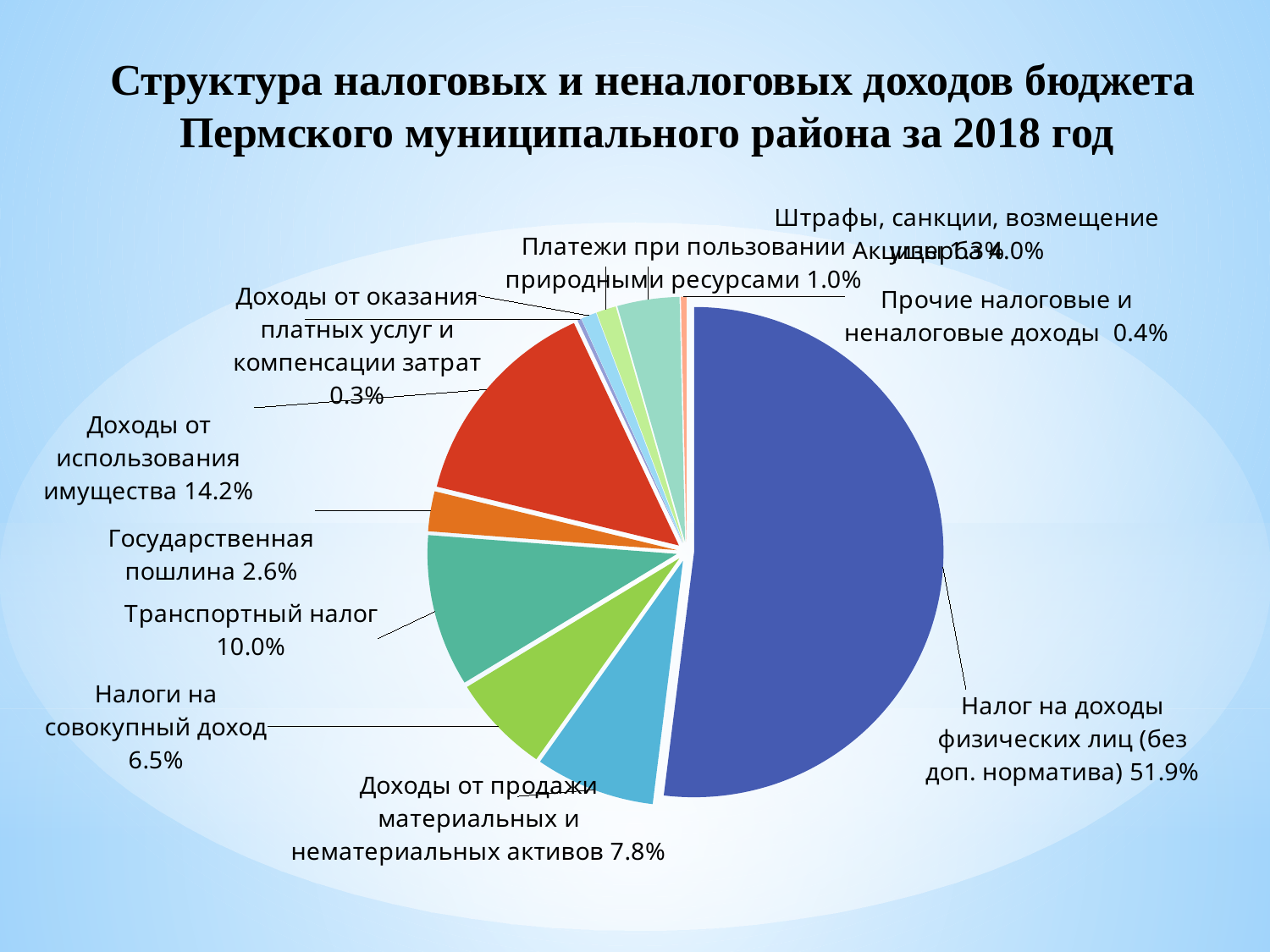
What share of the budget revenue is Налог на доходы физических лиц (без доп. норматива)? 51.9% What is the difference between Доходы от использования имущества and Транспортный налог? 4.2% What is the value for Доходы от продажи материальных и нематериальных активов? 7.8% What is the value for Транспортный налог? 10.0% What is the value for Государственная пошлина? 2.6% What is the value for Платежи при пользовании природными ресурсами? 1.0% Which category has the smallest share of the pie? Доходы от оказания платных услуг и компенсации затрат Which is larger: Налоги на совокупный доход or Доходы от продажи материальных и нематериальных активов? Доходы от продажи материальных и нематериальных активов Which category has the largest share of the pie? Налог на доходы физических лиц (без доп. норматива) What is the value for Доходы от использования имущества? 14.2% What kind of chart is shown on the slide? pie chart For which year does the chart show the budget revenue structure? 2018